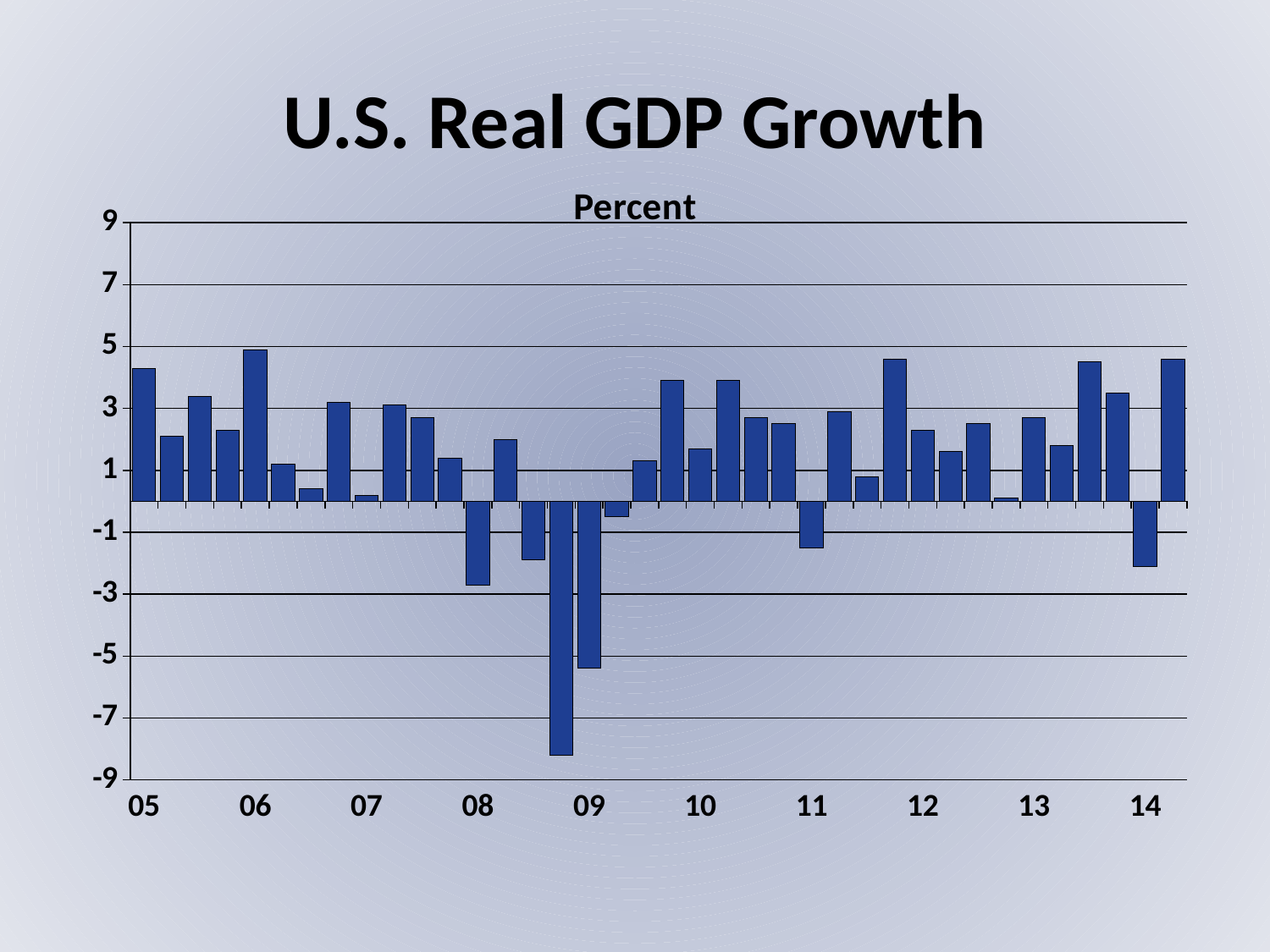
What unit label is shown above the vertical axis? Percent Do the values generally rise or fall from the start of 08 to the start of 09? fall How many year labels are shown along the x axis? 10 Is the first bar of 05 greater or less than 3? greater What kind of chart is shown on the slide? bar chart What is the title of the chart? U.S. Real GDP Growth Is the last bar on the chart (in 14) greater or less than 3? greater Is the first bar of 14 greater or less than -1? less Which is larger, the first bar of 05 or the first bar of 07? the first bar of 05 What is the highest value shown on the vertical axis? 9